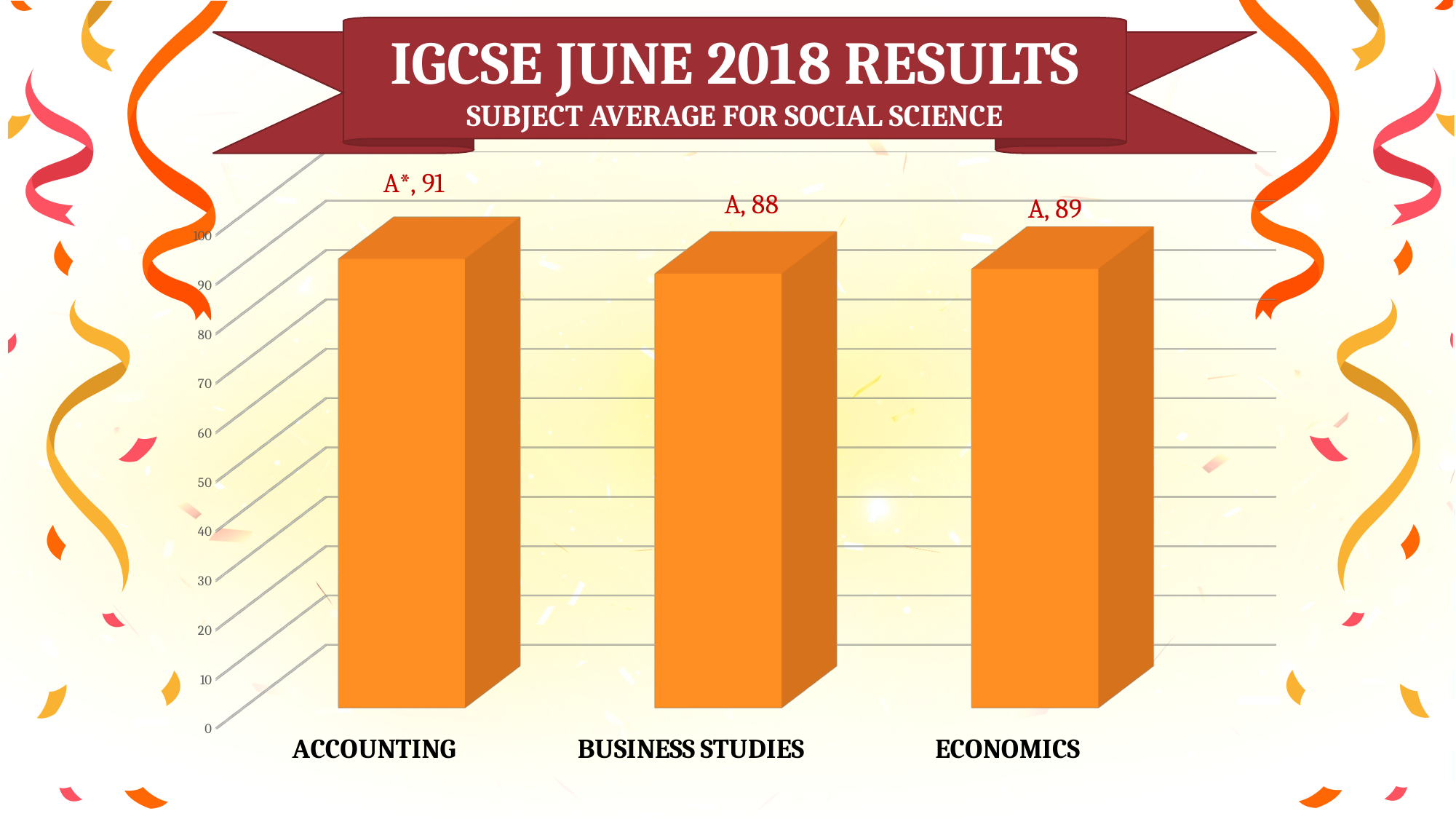
Which has a higher average, Accounting or Economics? Accounting What grade label is shown for Accounting? A* Which subject has the lowest average? Business Studies Which subject has the highest average? Accounting What kind of chart is shown on the slide? Bar chart What is the difference between the Accounting average and the Business Studies average? 3 What is the subject average for Accounting? 91 What is the difference between the Economics average and the Business Studies average? 1 What is the subject average for Business Studies? 88 Is the value for Business Studies greater or less than 80? greater How many subjects are shown in the chart? 3 What is the subject average for Economics? 89